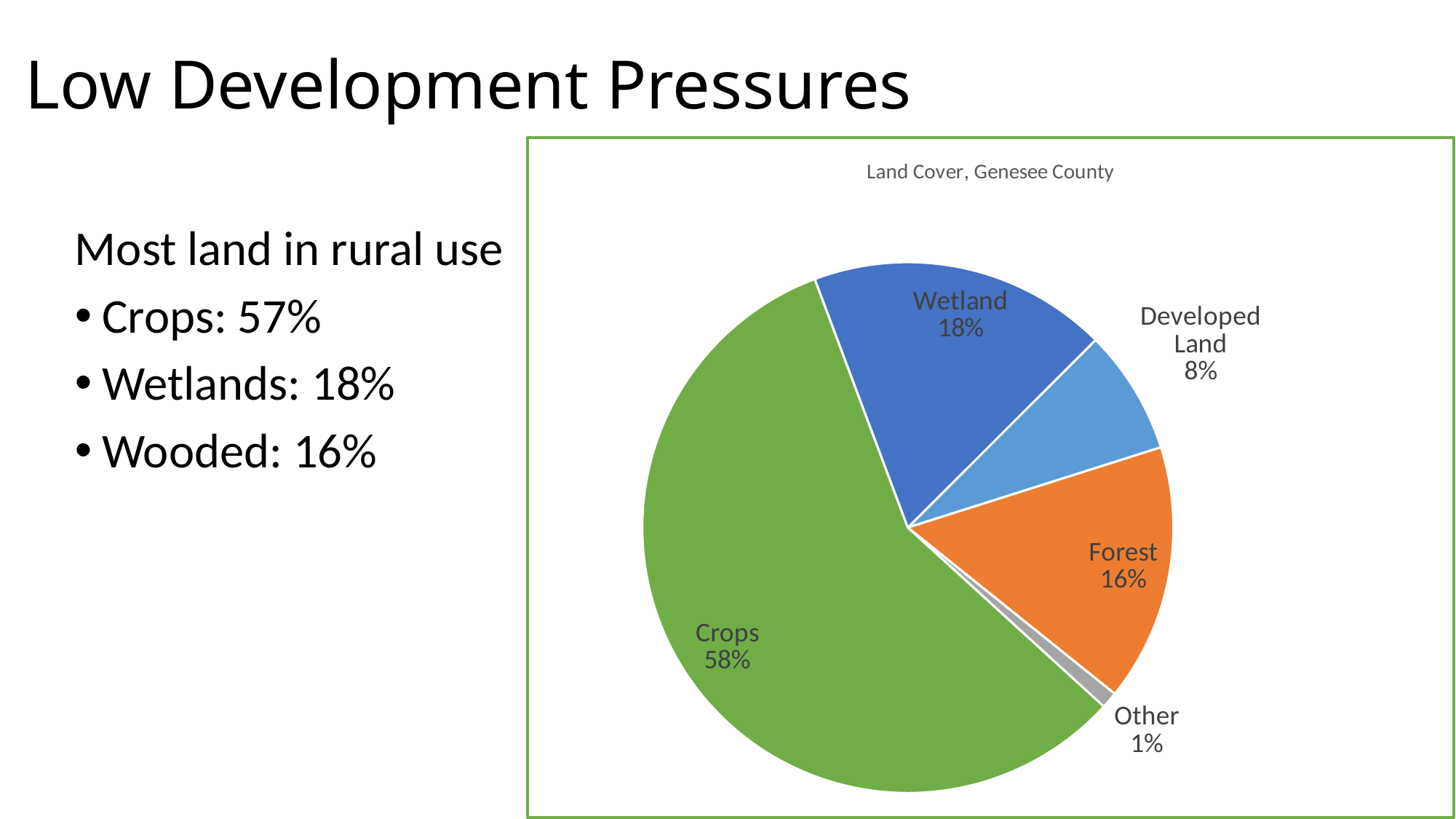
How many categories are shown in the pie chart? 5 What type of chart is shown on the slide? Pie chart What percentage is shown for Wetland in the pie chart? 18% What share of land cover does Crops account for in the pie chart? 58% Which category has the largest slice in the pie chart? Crops How many percentage points larger is Wetland than Forest in the pie chart? 2 What percentage is shown for Other in the pie chart? 1% Which category has the smallest slice in the pie chart? Other Which is larger in the pie chart, Developed Land or Forest? Forest What percentage is shown for Forest in the pie chart? 16% What is the title of the chart? Land Cover, Genesee County What percentage is shown for Developed Land in the pie chart? 8%